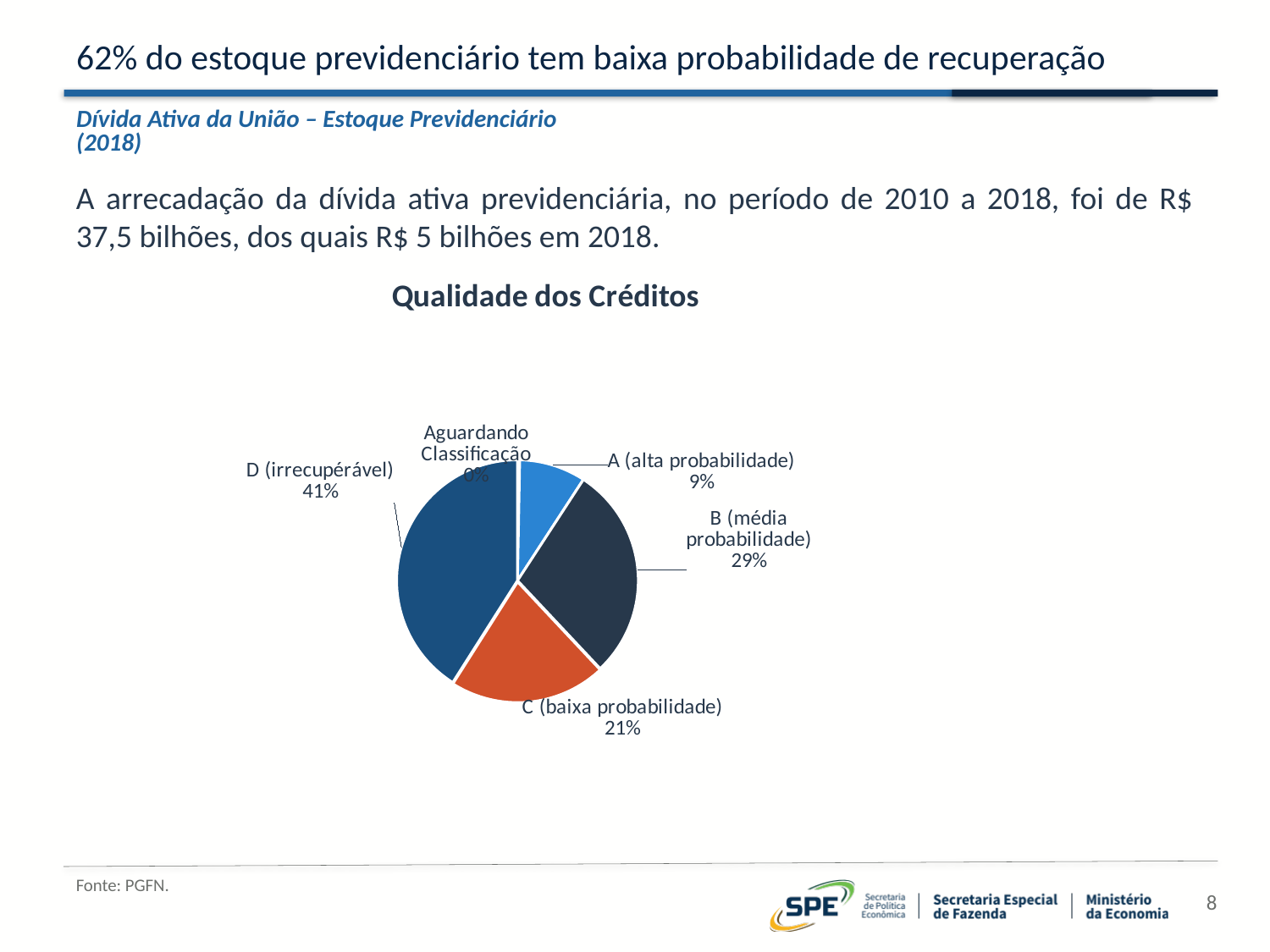
What is the title of the pie chart? Qualidade dos Créditos How many categories are labelled on the pie chart? 5 Which category has the smallest slice of the pie? Aguardando Classificação What share of the pie does A (alta probabilidade) represent? 9% What share of the pie does D (irrecupérável) represent? 41% What is the difference in percentage points between D (irrecupérável) and C (baixa probabilidade)? 20 What kind of chart is shown under the title "Qualidade dos Créditos"? Pie chart What percentage is shown for Aguardando Classificação? 0% What share of the pie does C (baixa probabilidade) represent? 21% Which category has the largest slice of the pie? D (irrecupérável) Which is larger, the share for B (média probabilidade) or the share for C (baixa probabilidade)? B (média probabilidade)